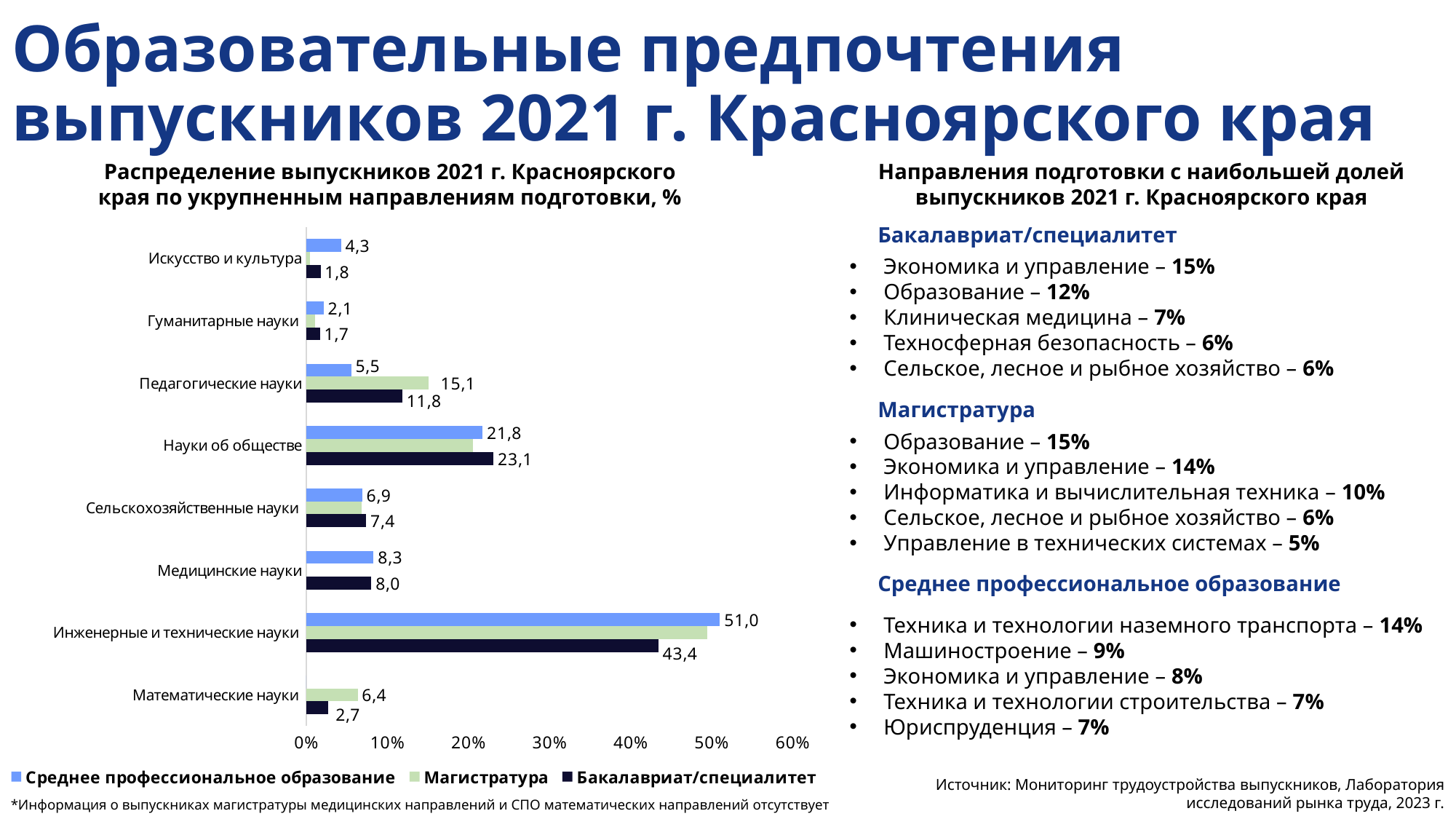
What is the value for Магистратура in the Педагогические науки category? 15,1 What is the difference between the Среднее профессиональное образование and Бакалавриат/специалитет values for Инженерные и технические науки? 7,6 What is the value for Бакалавриат/специалитет in the Науки об обществе category? 23,1 Which category has the highest value for Среднее профессиональное образование? Инженерные и технические науки In the Науки об обществе category, which is larger: Среднее профессиональное образование or Бакалавриат/специалитет? Бакалавриат/специалитет Which category has the lowest value for Бакалавриат/специалитет? Гуманитарные науки How many series does the chart legend list? 3 How many categories are shown on the chart's vertical axis? 8 Is the Магистратура value for Инженерные и технические науки greater or less than 40%? greater What kind of chart is shown on the slide? Bar chart What is the value for Среднее профессиональное образование in the Инженерные и технические науки category? 51,0 What is the value for Бакалавриат/специалитет in the Математические науки category? 2,7